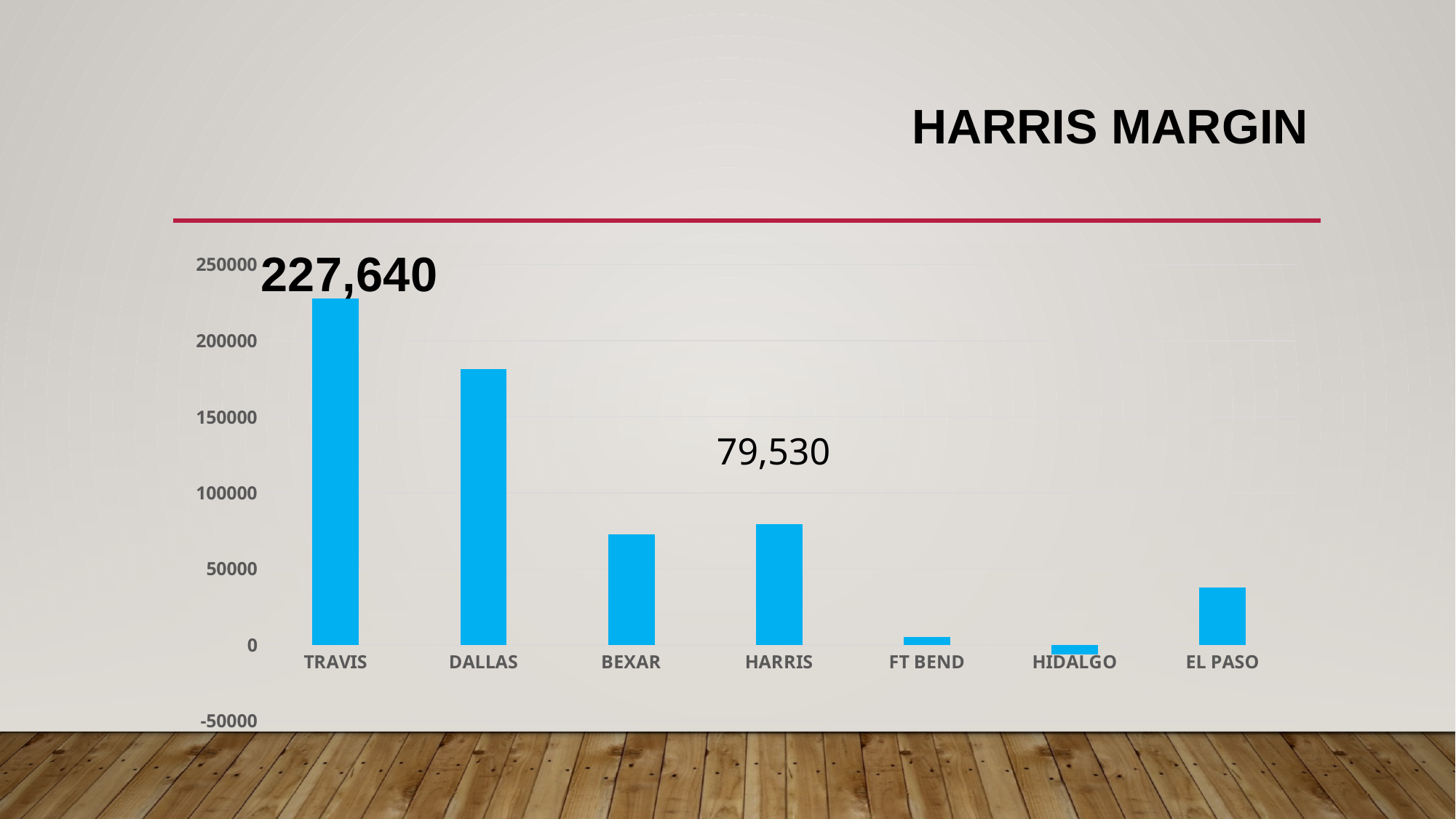
Which county has the highest value? TRAVIS How many counties are shown on the x axis? 7 Is the value for BEXAR greater or less than 100000? less What is the value for HARRIS? 79,530 What is the value for TRAVIS? 227,640 What kind of chart is shown on the slide? bar chart Which has a larger value, EL PASO or FT BEND? EL PASO Which has a larger value, DALLAS or BEXAR? DALLAS Is the value for DALLAS greater or less than 150000? greater What is the difference between the values for TRAVIS and HARRIS? 148,110 Which county has the lowest value? HIDALGO Is the value for EL PASO greater or less than 50000? less